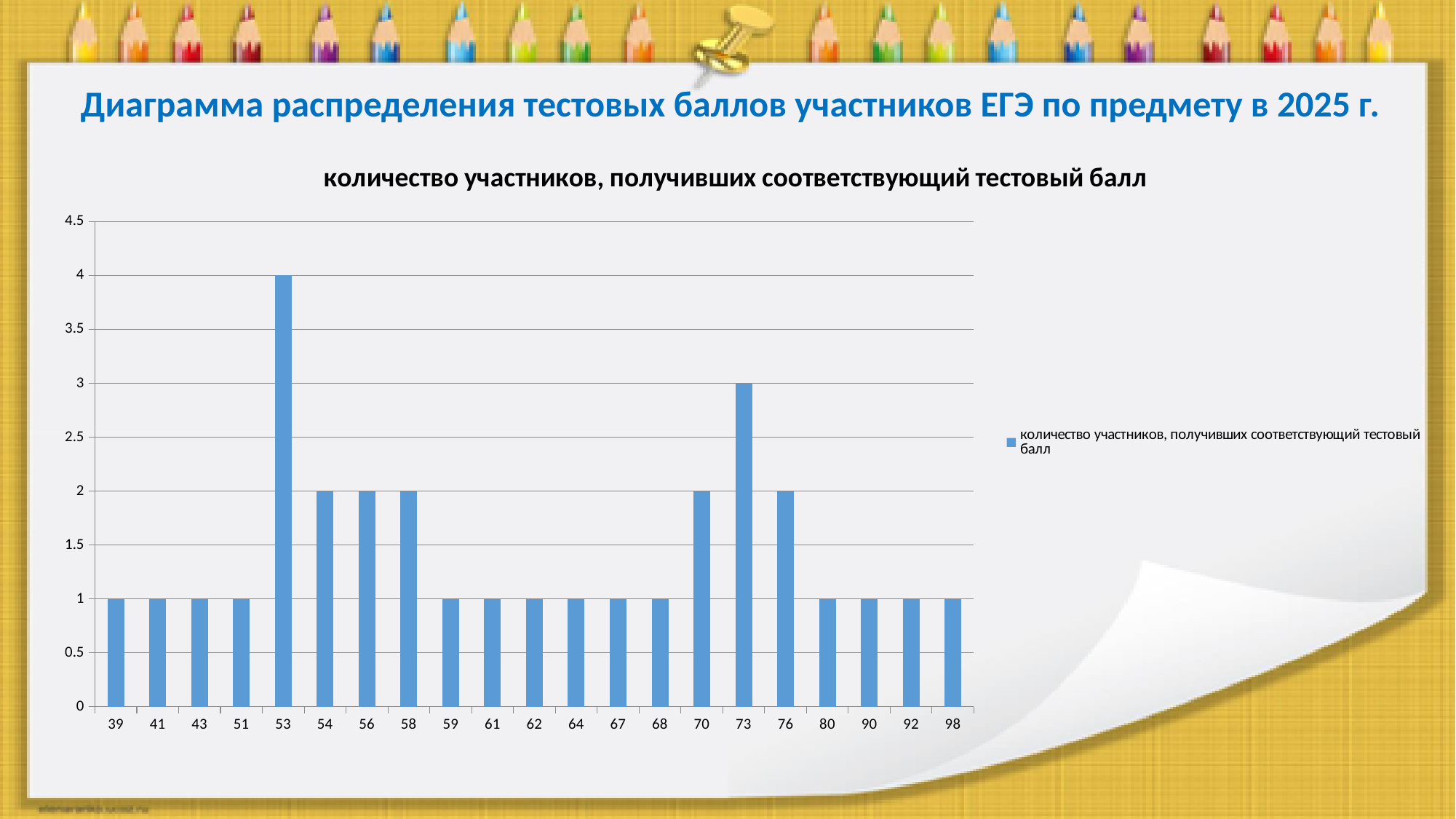
What kind of chart is shown on the slide? bar chart What is the number of participants who received a test score of 73? 3 How many series does the legend list? 1 Which test score has the highest number of participants? 53 Is the value for a score of 53 greater or less than 3? greater What is the number of participants who received a test score of 53? 4 Which has more participants: a score of 70 or a score of 80? 70 What is the title of the chart? количество участников, получивших соответствующий тестовый балл What is the number of participants who received a test score of 56? 2 What is the difference between the number of participants with a score of 53 and those with a score of 73? 1 What is the number of participants who received a test score of 98? 1 How many score categories are shown on the x axis? 21